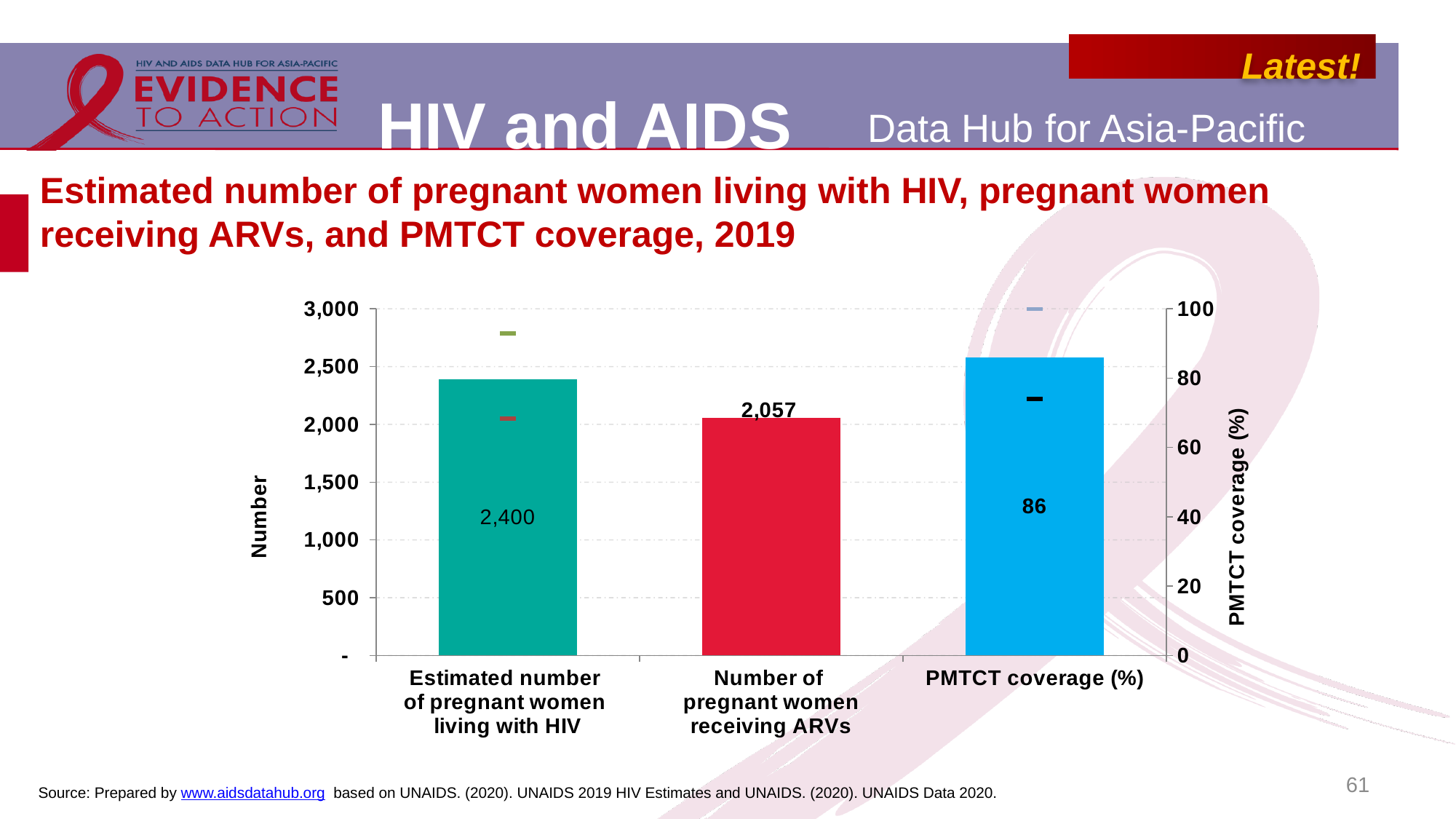
What is the title of the left vertical axis of the chart? Number What is the PMTCT coverage (%) value shown on the chart? 86 How many bars are plotted on the chart? 3 What is the number of pregnant women receiving ARVs shown on the chart? 2,057 What is the estimated number of pregnant women living with HIV shown on the chart? 2,400 Which is larger: the estimated number of pregnant women living with HIV or the number of pregnant women receiving ARVs? Estimated number of pregnant women living with HIV What year does the chart title say the data refer to? 2019 Is the PMTCT coverage (%) value greater or less than 80? greater What is the title of the right vertical axis of the chart? PMTCT coverage (%) What kind of chart is shown on the slide? Bar chart What is the difference between the estimated number of pregnant women living with HIV and the number of pregnant women receiving ARVs? 343 Is the number of pregnant women receiving ARVs greater or less than 2,500? less